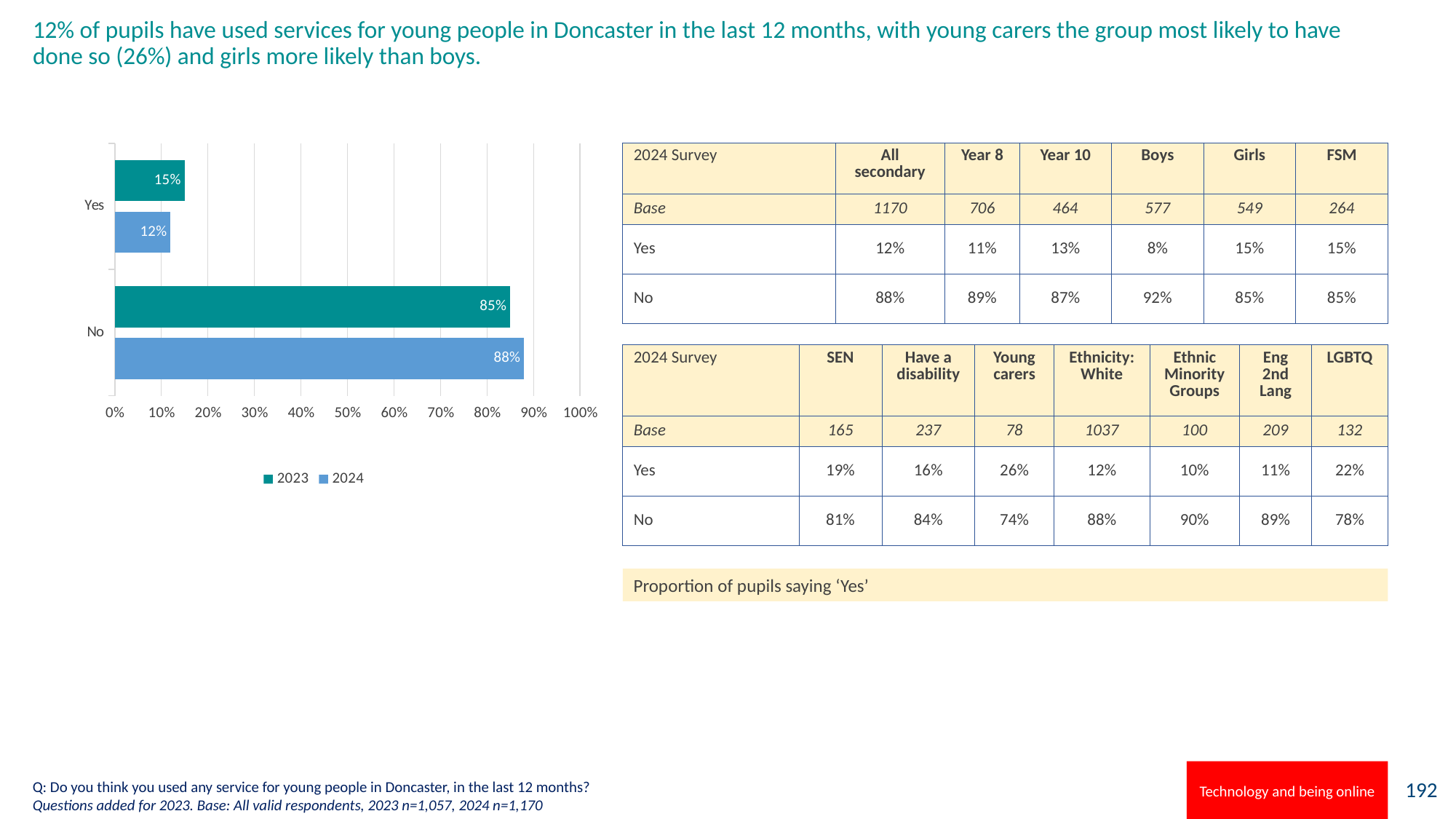
Which category has the lowest value in the 2023 series? Yes What is the difference between the 2023 and 2024 values for 'Yes'? 3% What kind of chart is shown on the slide? Bar chart What is the value for 'Yes' in the 2024 series? 12% What is the difference between the 2024 and 2023 values for 'No'? 3% How many series does the legend list? 2 What is the value for 'No' in the 2024 series? 88% How many categories are shown on the chart? 2 Which is larger for 'Yes': the 2023 value or the 2024 value? 2023 What is the value for 'Yes' in the 2023 series? 15% Which category has the highest value in the 2024 series? No What is the value for 'No' in the 2023 series? 85%